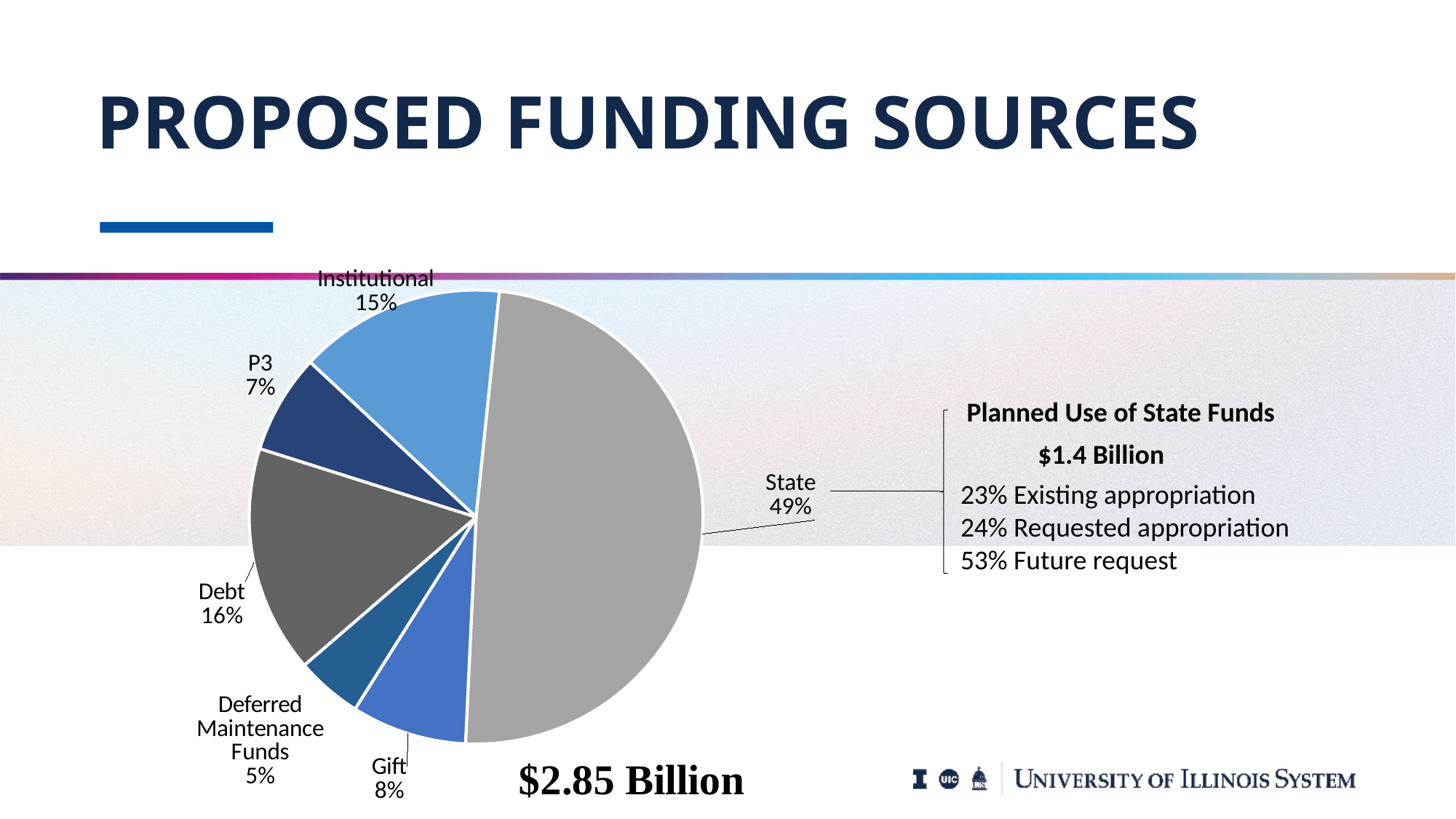
What total dollar amount is shown beneath the pie chart? $2.85 Billion What share of the pie does State represent? 49% What share of the pie does Debt represent? 16% What share of the pie does Institutional represent? 15% Which funding source has the largest slice of the pie? State What is the difference in percentage points between the State share and the Debt share? 33 What kind of chart is shown on the slide? pie chart How many slices does the pie chart have? 6 Which funding source has the smallest slice of the pie? Deferred Maintenance Funds Which is larger, the share for P3 or the share for Gift? Gift